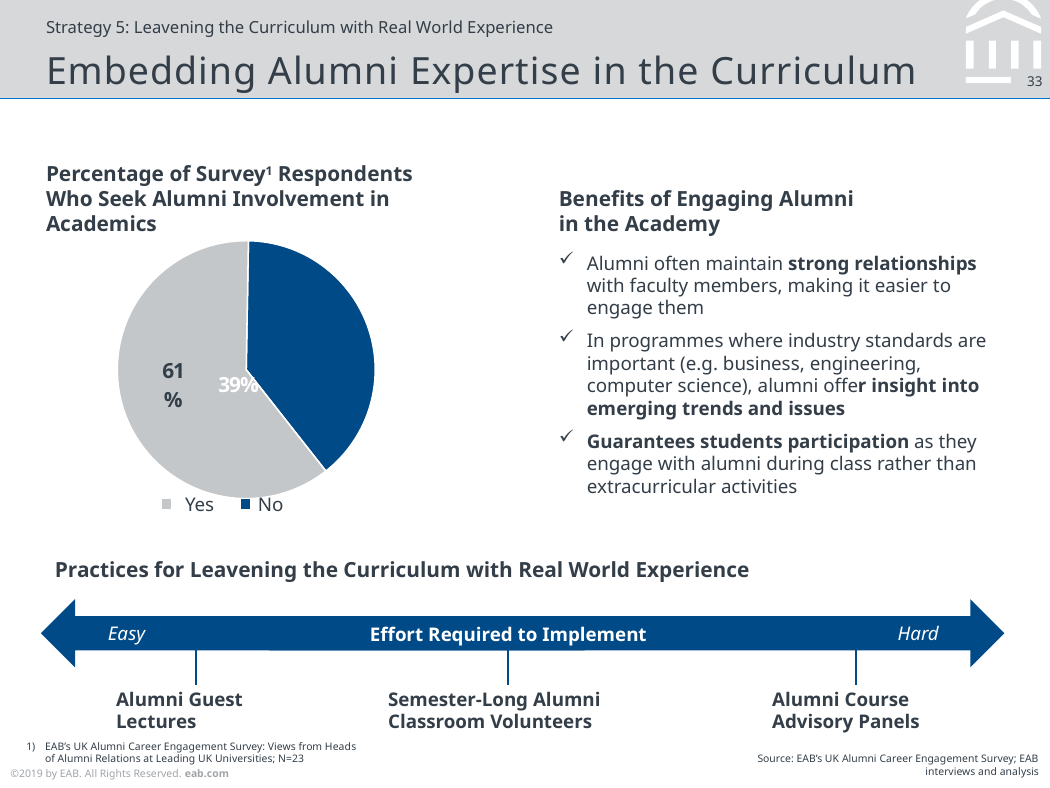
What percentage of survey respondents answered "Yes" to seeking alumni involvement in academics? 61% What percentage of survey respondents answered "No"? 39% How many entries does the pie chart's legend list? 2 Which slice of the pie chart is the largest? Yes Which is larger, the "Yes" share or the "No" share? Yes What colour is the "No" slice in the pie chart? Blue How many slices does the pie chart have? 2 What is the title of the pie chart? Percentage of Survey Respondents Who Seek Alumni Involvement in Academics What is the difference in percentage points between the "Yes" and "No" slices? 22 Which slice of the pie chart is the smallest? No What share of the pie does the "No" slice represent? 39% What kind of chart is shown on the slide? Pie chart